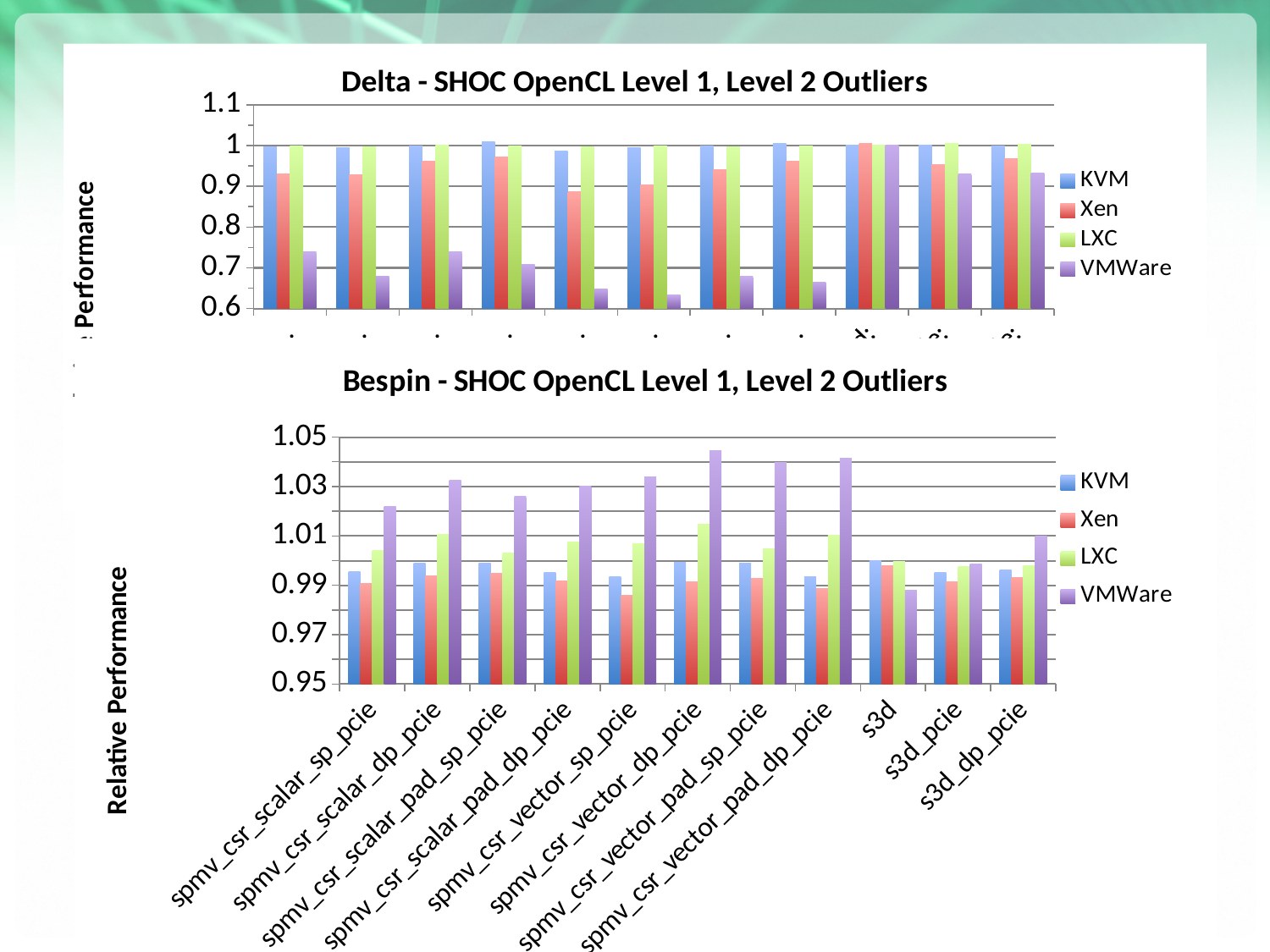
In the Bespin - SHOC OpenCL Level 1, Level 2 Outliers chart, how many categories are shown on the x axis? 11 How many series does the legend of the Delta - SHOC OpenCL Level 1, Level 2 Outliers chart list? 4 In the Delta - SHOC OpenCL Level 1, Level 2 Outliers chart, is the VMWare value for the first category group greater or less than 0.8? less What kind of chart is the Bespin - SHOC OpenCL Level 1, Level 2 Outliers chart? bar chart In the Bespin - SHOC OpenCL Level 1, Level 2 Outliers chart, which series has the lowest value for spmv_csr_vector_sp_pcie? Xen In the Bespin - SHOC OpenCL Level 1, Level 2 Outliers chart, which series has the highest value for spmv_csr_vector_dp_pcie? VMWare What is the y-axis label of the Bespin - SHOC OpenCL Level 1, Level 2 Outliers chart? Relative Performance In the Bespin - SHOC OpenCL Level 1, Level 2 Outliers chart, is the VMWare value for spmv_csr_vector_pad_sp_pcie greater or less than 1.03? greater What is the title of the top chart on the slide? Delta - SHOC OpenCL Level 1, Level 2 Outliers In the Bespin - SHOC OpenCL Level 1, Level 2 Outliers chart, which is larger for spmv_csr_scalar_dp_pcie, the VMWare value or the Xen value? VMWare In the Bespin - SHOC OpenCL Level 1, Level 2 Outliers chart, is the LXC value for spmv_csr_vector_dp_pcie greater or less than 1.01? greater In the Delta - SHOC OpenCL Level 1, Level 2 Outliers chart, which series has the lowest value in the first category group? VMWare